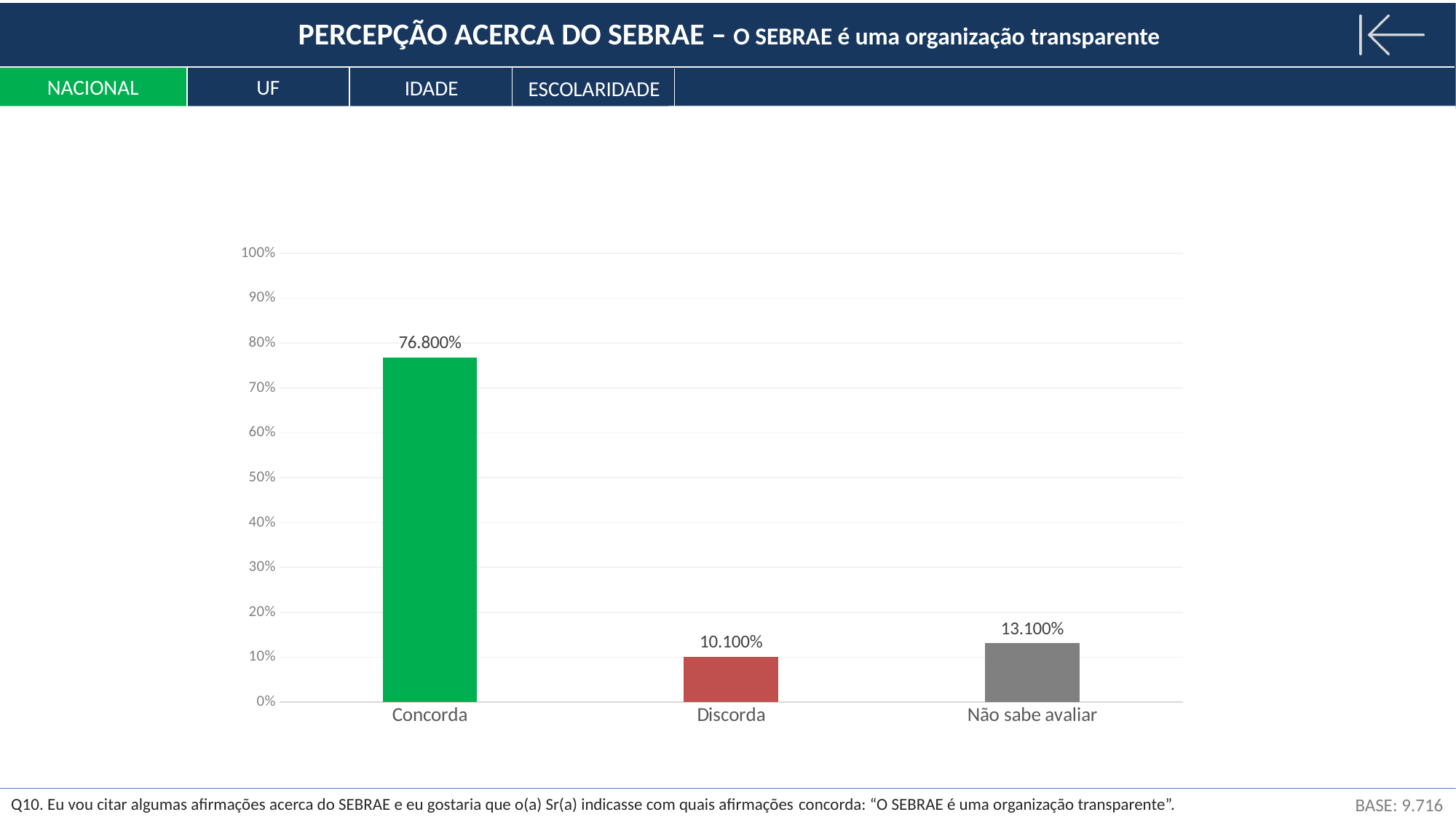
What kind of chart is shown on the slide? bar chart What is the difference between the values for Não sabe avaliar and Discorda? 3.000% What is the value for Discorda? 10.100% What is the difference between the values for Concorda and Discorda? 66.700% Which category has the highest value? Concorda Which is larger, the value for Discorda or the value for Não sabe avaliar? Não sabe avaliar Is the value for Concorda greater or less than 70%? greater How many categories are shown on the x axis? 3 What is the value for Não sabe avaliar? 13.100% Which category has the lowest value? Discorda What colour is the bar for Discorda? red What is the value for Concorda? 76.800%